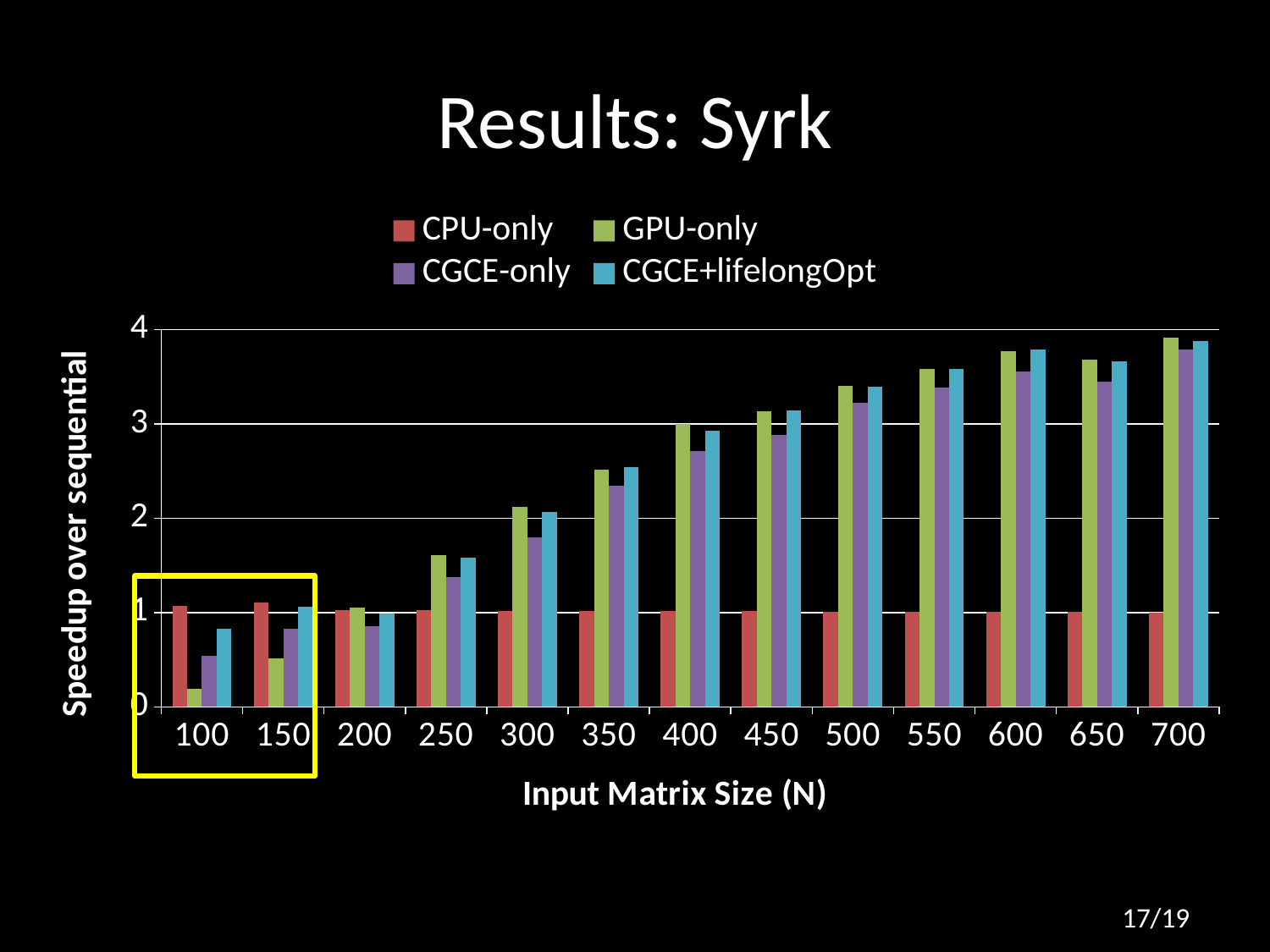
Is the CGCE+lifelongOpt value for N=500 greater or less than 3? greater Does the GPU-only speedup generally rise or fall as the input matrix size increases? rise How many series does the legend list? 4 What kind of chart is shown on the slide? bar chart Is the CGCE-only value for N=250 greater or less than 2? less At which input matrix size is the GPU-only speedup highest? 700 Is the GPU-only value for N=700 greater or less than 3? greater Which series has the lowest value at N=100? GPU-only How many input matrix sizes are shown on the x axis? 13 What is the label of the x axis? Input Matrix Size (N) At N=100, which is larger: CPU-only or GPU-only? CPU-only